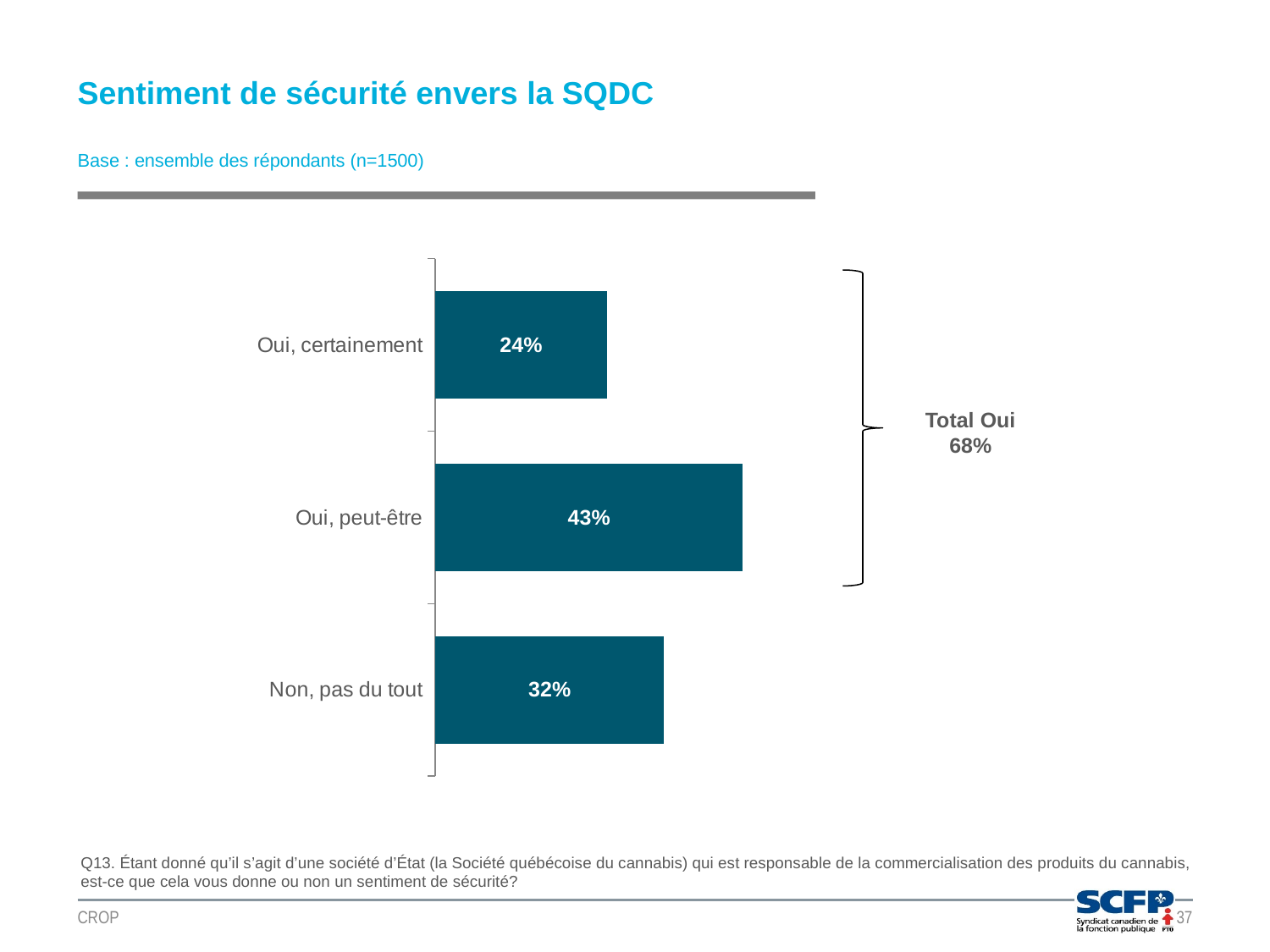
What is the value for "Oui, certainement"? 24% How many categories are shown in the chart? 3 What kind of chart is shown on the slide? Bar chart What is the value for "Non, pas du tout"? 32% What is the "Total Oui" value shown next to the bracket? 68% What is the title of the chart? Sentiment de sécurité envers la SQDC Which category has the lowest value? Oui, certainement Which category has the highest value? Oui, peut-être Which is larger, the value for "Oui, certainement" or the value for "Non, pas du tout"? Non, pas du tout What is the difference between the values for "Oui, peut-être" and "Non, pas du tout"? 11% What is the difference between the values for "Non, pas du tout" and "Oui, certainement"? 8% What is the value for "Oui, peut-être"? 43%